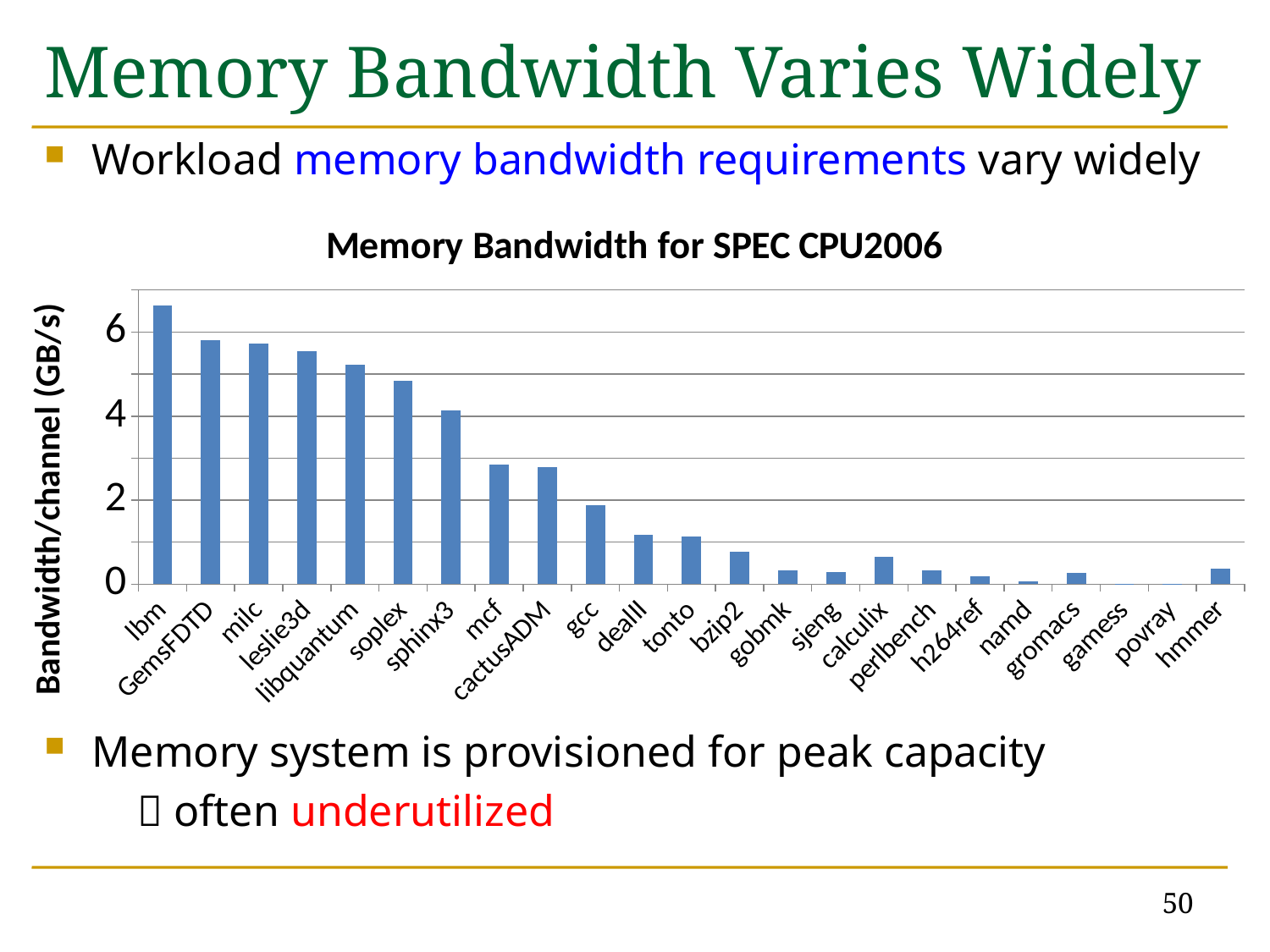
What is the title of the chart? Memory Bandwidth for SPEC CPU2006 Is the value for mcf greater or less than 4? less Is the value for lbm greater or less than 6? greater Is the value for libquantum greater or less than 4? greater What type of chart is shown on the slide? bar chart Which benchmark has the highest bandwidth per channel? lbm How many benchmarks are plotted on the x axis? 23 Which has a higher bandwidth per channel, calculix or gobmk? calculix Which has a higher bandwidth per channel, milc or gcc? milc Do the bandwidth values generally rise or fall from left to right along the x axis? fall What is the label of the vertical axis? Bandwidth/channel (GB/s)